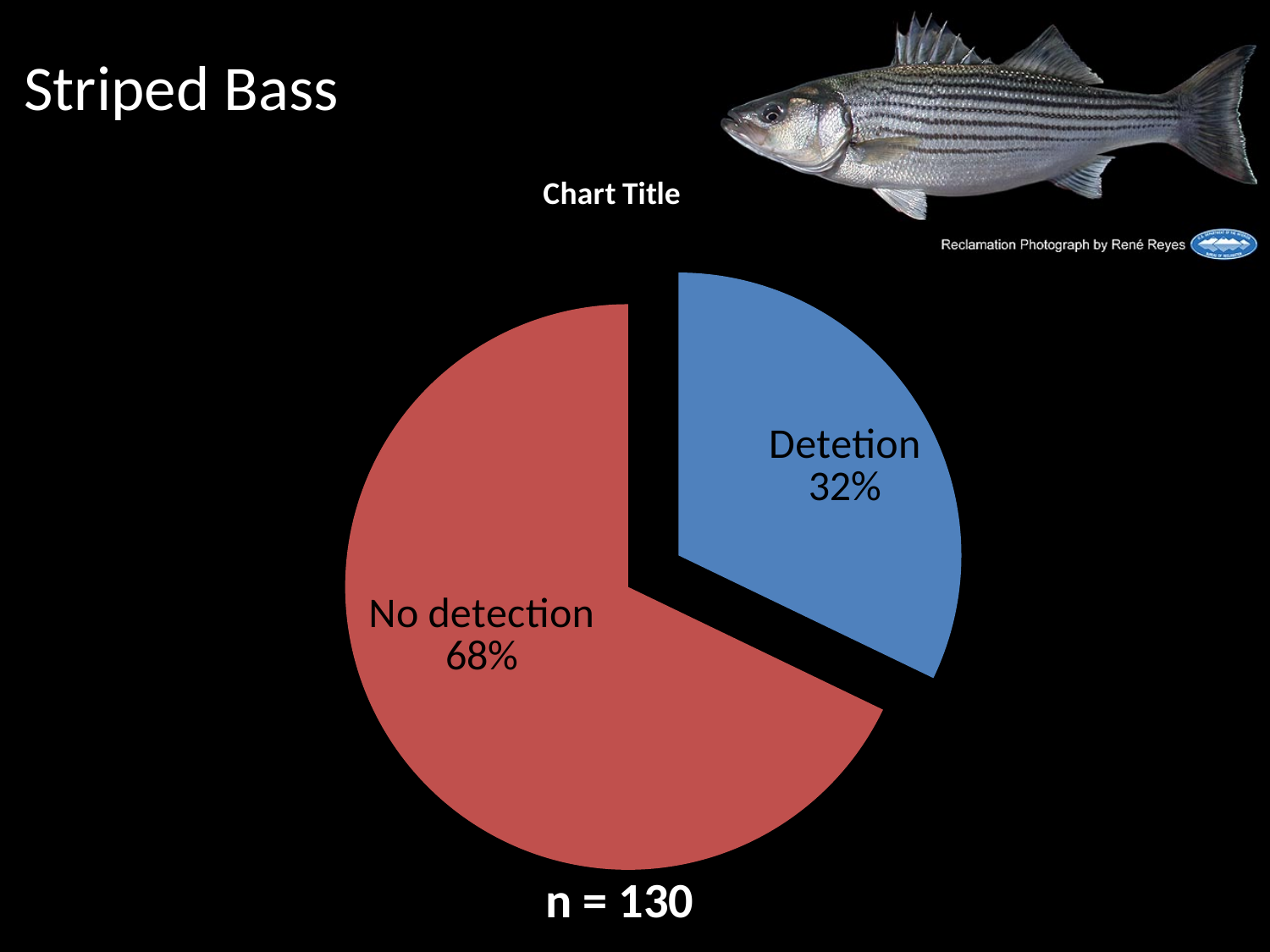
Which is larger, the Detection slice or the No detection slice? No detection What percentage of the pie is labelled No detection? 68% What colour is the Detection slice? blue Which slice of the pie is the largest? No detection What sample size is printed below the pie chart? n = 130 What is the share of the pie taken by the Detection slice? 32% What percentage of the pie is labelled Detection? 32% Which slice of the pie is the smallest? Detection What type of chart is shown on the slide? pie chart What is the difference in percentage points between the No detection and Detection slices? 36 How many slices does the pie chart have? 2